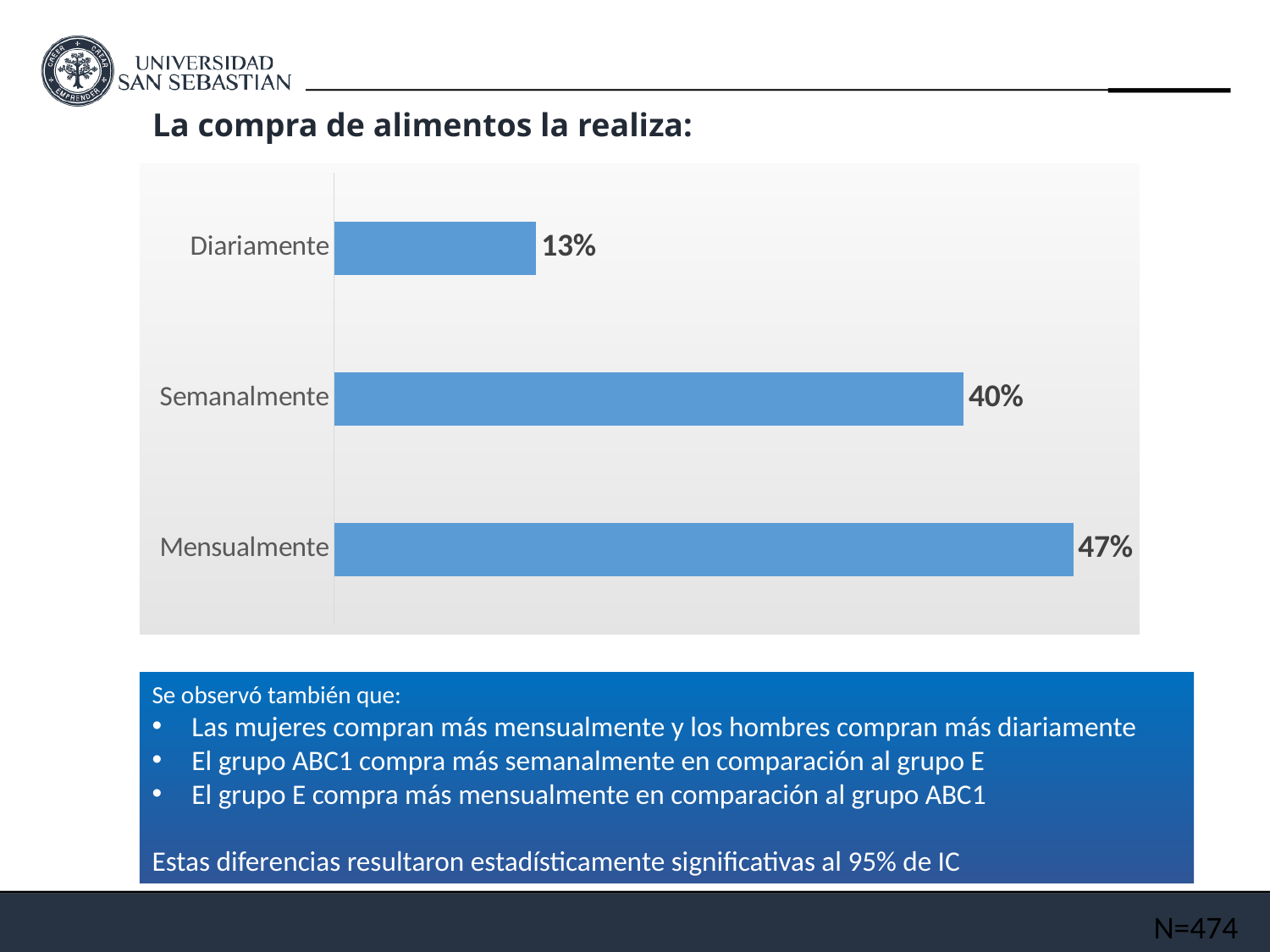
Which category has the lowest value? Diariamente What is the value for Diariamente? 13% What is the value for Mensualmente? 47% Which category has the highest value? Mensualmente What kind of chart is shown on the slide? bar chart What colour are the bars in the chart? blue What is the difference between the values for Semanalmente and Diariamente? 27% What is the title above the chart? La compra de alimentos la realiza: Which is larger, the value for Semanalmente or the value for Diariamente? Semanalmente What is the difference between the values for Mensualmente and Semanalmente? 7% How many categories are shown in the chart? 3 What is the value for Semanalmente? 40%